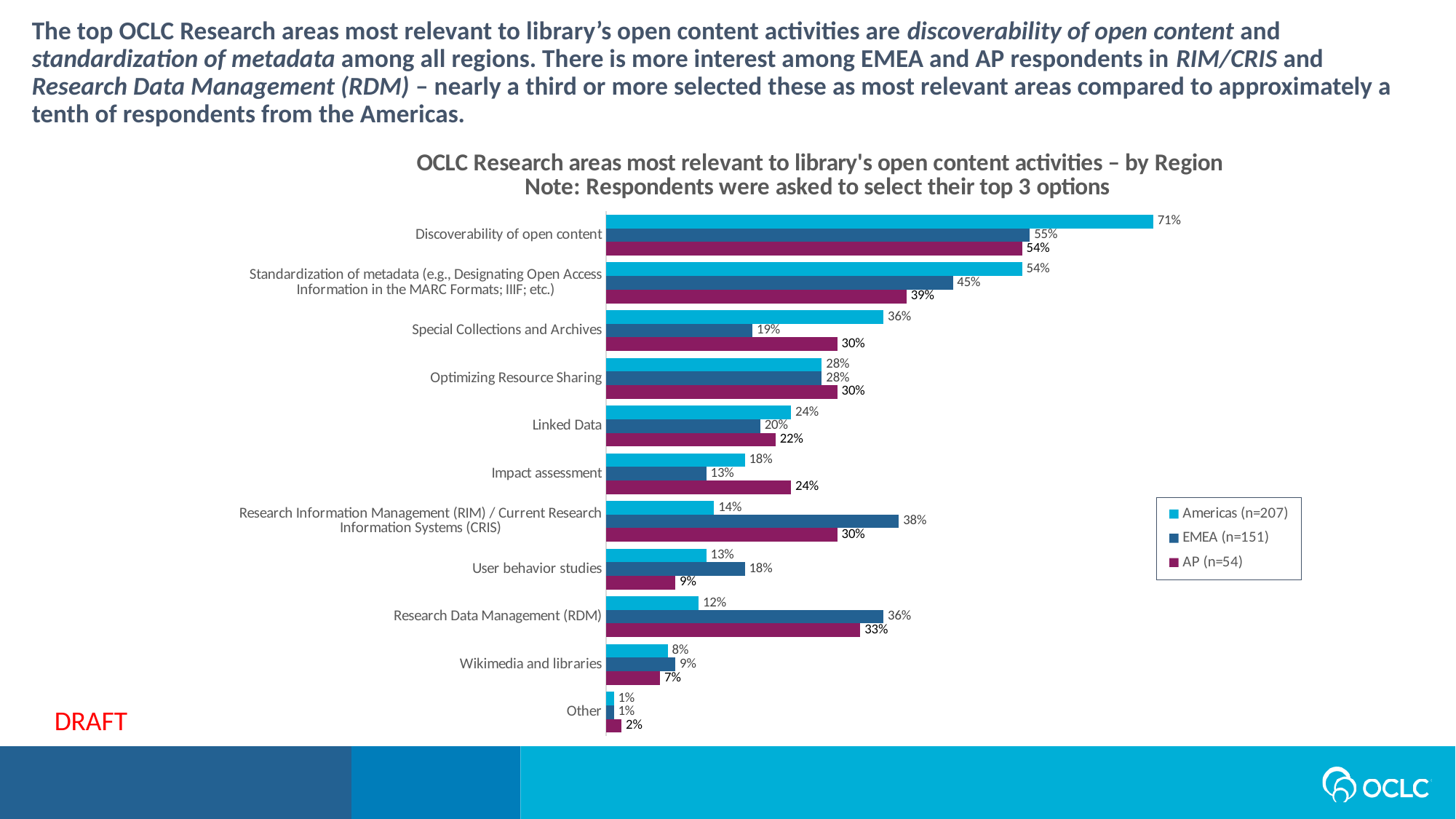
What is the difference between the EMEA and Americas values for Research Data Management (RDM)? 24% What percentage of Americas respondents selected Discoverability of open content? 71% How many series does the legend list? 3 What is the AP value for Research Data Management (RDM)? 33% What is the difference between the Americas and EMEA values for Discoverability of open content? 16% Which category has the highest value for the Americas series? Discoverability of open content What is the EMEA value for Research Information Management (RIM) / Current Research Information Systems (CRIS)? 38% Which is larger for Special Collections and Archives: the EMEA value or the AP value? AP How many categories are shown on the chart? 11 What kind of chart is shown on the slide? Bar chart What is the sample size (n) for the EMEA series shown in the legend? 151 Which category has the lowest value for the AP series? Other